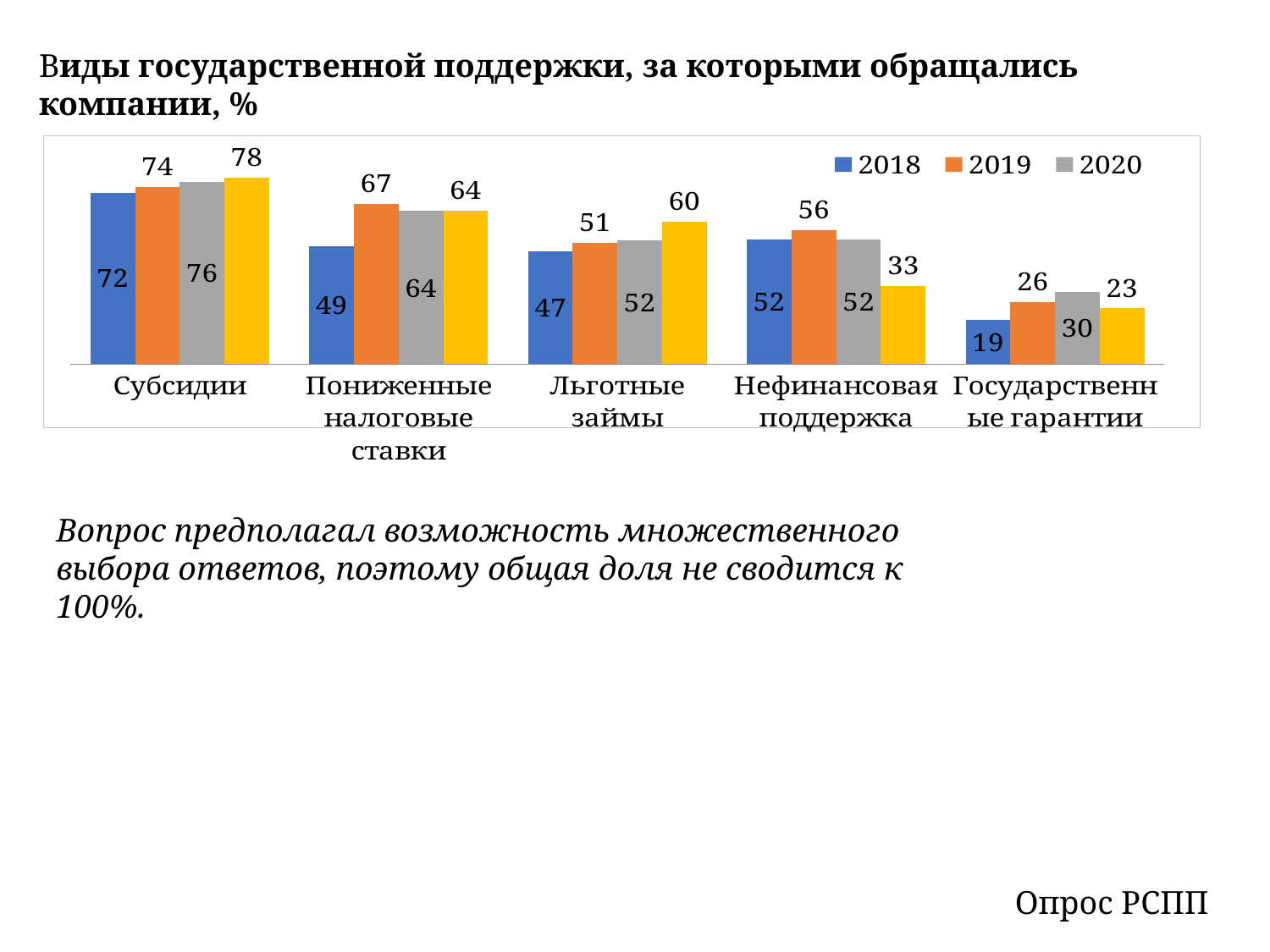
What is the value for Субсидии in 2018? 72 What is the value for Льготные займы in 2020? 52 In 2019, which is larger: Льготные займы or Нефинансовая поддержка? Нефинансовая поддержка What is the value for Государственные гарантии in 2020? 30 How many series does the legend list? 3 Which category has the lowest value in 2018? Государственные гарантии Which category has the highest value in 2019? Субсидии What is the value for Пониженные налоговые ставки in 2019? 67 How many categories are shown on the x axis? 5 What is the difference between the 2020 values for Субсидии and Государственные гарантии? 46 Do the values for Субсидии rise or fall from 2018 to 2020? rise What kind of chart is shown on the slide? bar chart